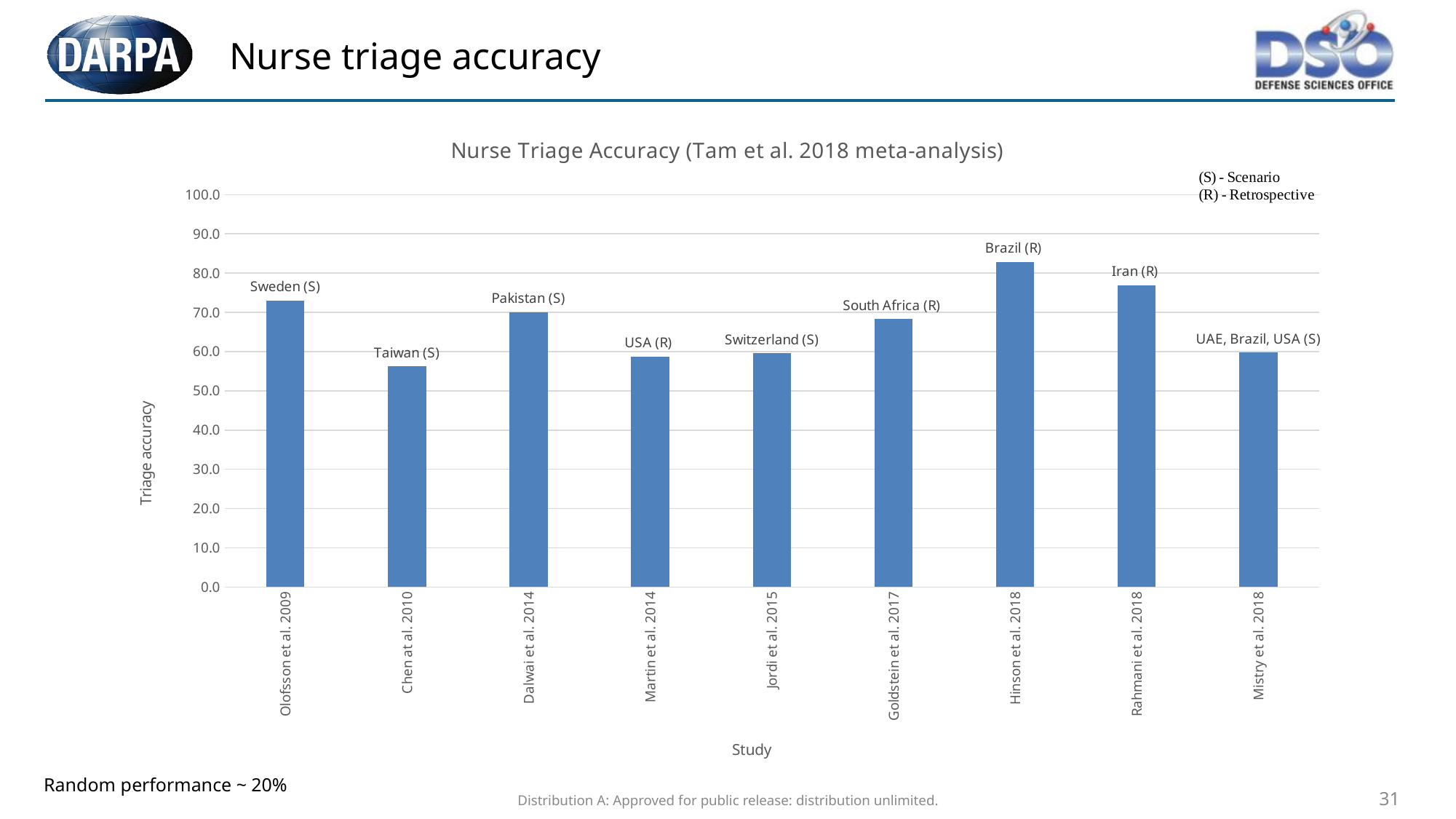
Is the triage accuracy for Hinson et al. 2018 greater or less than 80.0? greater Which has the higher triage accuracy, Hinson et al. 2018 or Rahmani et al. 2018? Hinson et al. 2018 Is the triage accuracy for Olofsson et al. 2009 greater or less than 70.0? greater Which study has the highest triage accuracy? Hinson et al. 2018 What is the title of the chart? Nurse Triage Accuracy (Tam et al. 2018 meta-analysis) Which study has the lowest triage accuracy? Chen at al. 2010 What is the label of the y axis? Triage accuracy Is the triage accuracy for Goldstein et al. 2017 greater or less than 60.0? greater What kind of chart is shown on the slide? bar chart How many studies are plotted on the x axis? 9